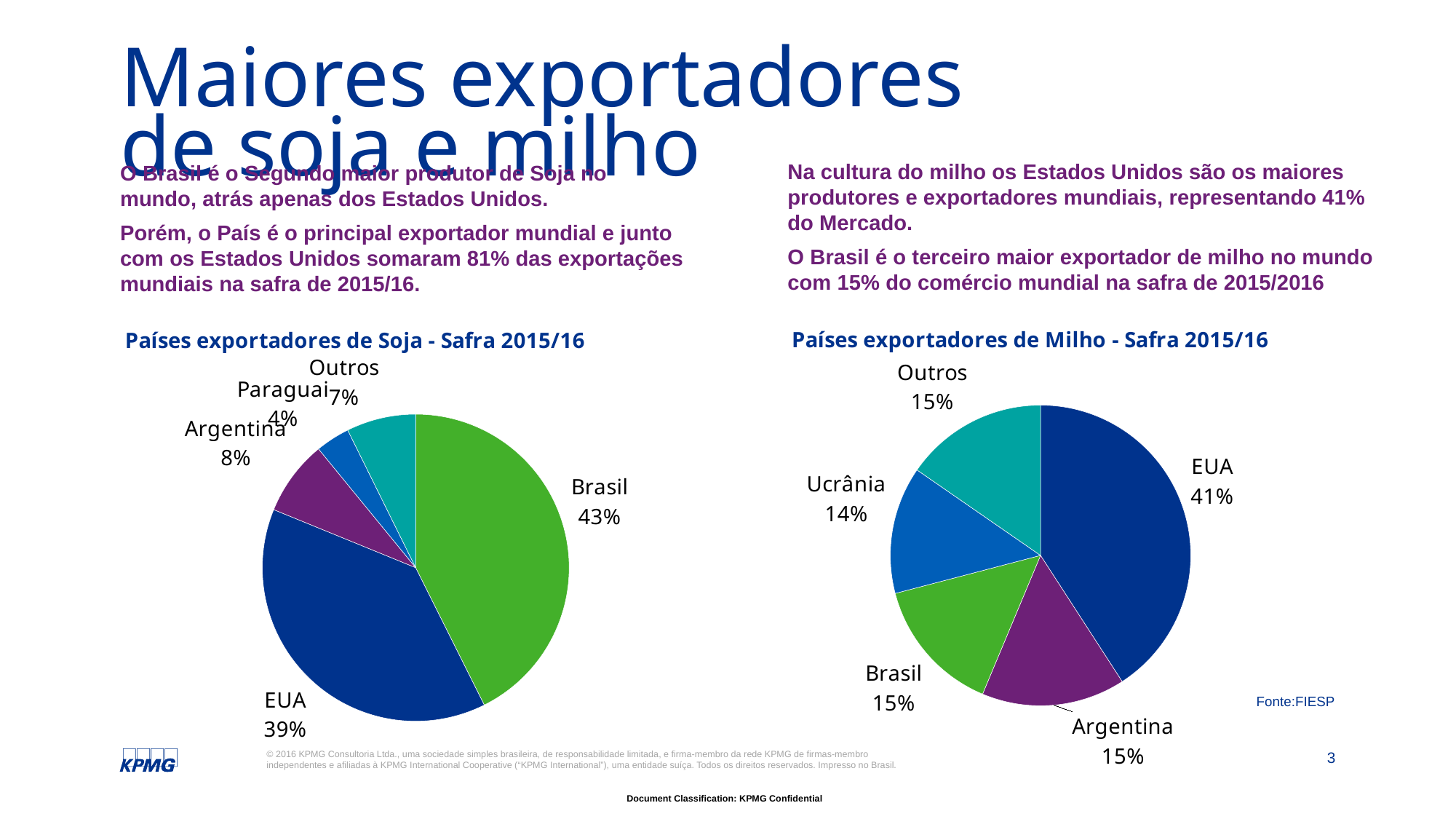
What type of chart is 'Países exportadores de Milho - Safra 2015/16'? Pie chart In the 'Países exportadores de Soja - Safra 2015/16' chart, what share does EUA have? 39% In the 'Países exportadores de Milho - Safra 2015/16' chart, what share does Ucrânia have? 14% In the 'Países exportadores de Soja - Safra 2015/16' chart, which category has the largest slice? Brasil In the 'Países exportadores de Soja - Safra 2015/16' chart, which country has the smallest slice? Paraguai In the 'Países exportadores de Milho - Safra 2015/16' chart, what is the difference between the EUA and Brasil shares? 26% In the 'Países exportadores de Soja - Safra 2015/16' chart, what is the difference between the Brasil and EUA shares? 4% In the 'Países exportadores de Soja - Safra 2015/16' chart, which is larger: Argentina or Outros? Argentina In the 'Países exportadores de Soja - Safra 2015/16' chart, what share does Brasil have? 43% In the 'Países exportadores de Soja - Safra 2015/16' chart, how many slices are there? 5 In the 'Países exportadores de Milho - Safra 2015/16' chart, what share does EUA have? 41% In the 'Países exportadores de Milho - Safra 2015/16' chart, which category has the largest slice? EUA